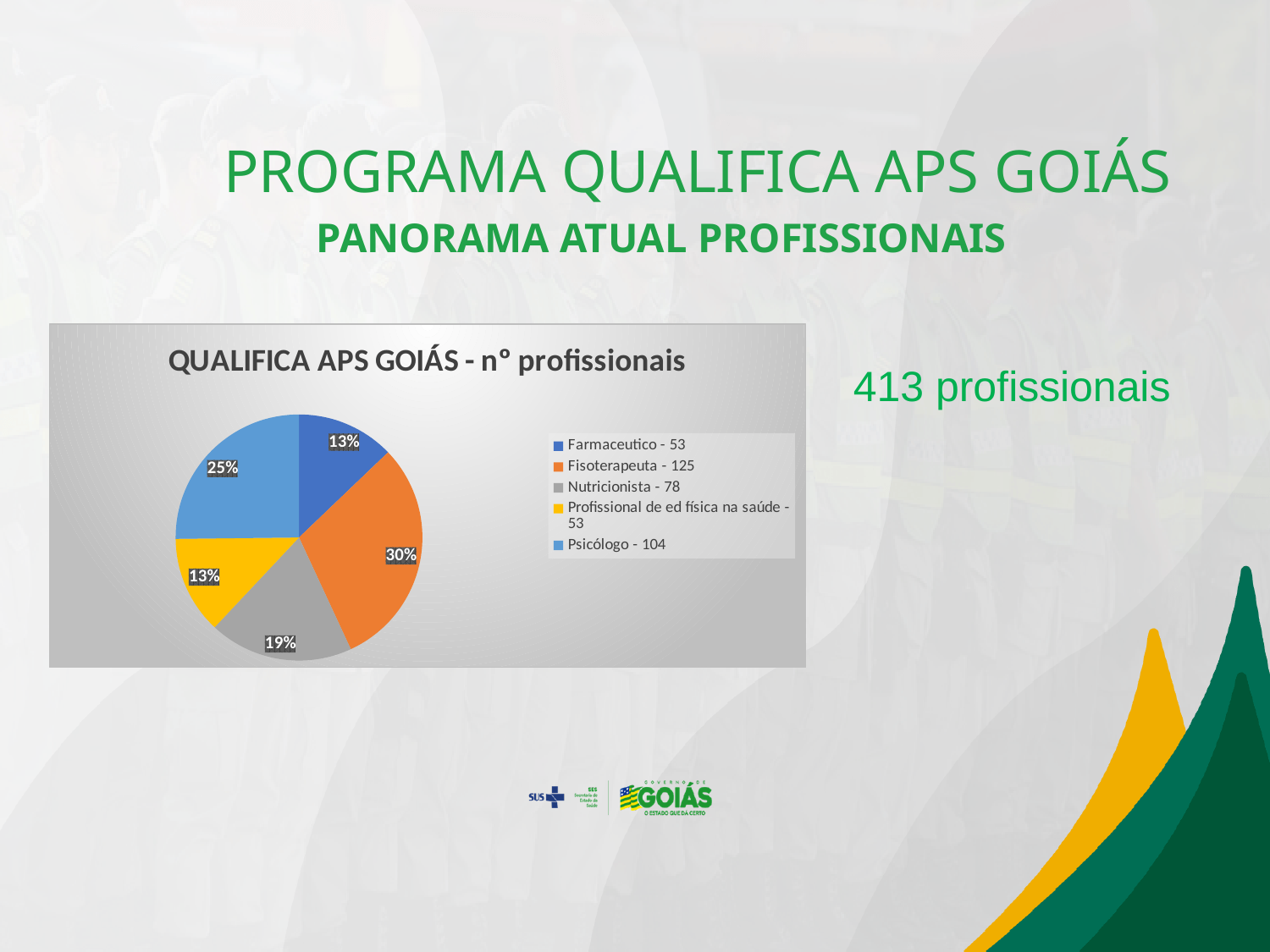
What share of the pie does Fisoterapeuta represent? 30% What is the difference between the number of Fisoterapeuta and Nutricionista professionals? 47 How many categories does the pie chart have? 5 What is the total number of professionals shown on the slide? 413 profissionais What type of chart is shown on the slide? pie chart Which has more professionals, Psicólogo or Farmaceutico? Psicólogo How many professionals are listed for Nutricionista in the legend? 78 Which category has the largest slice of the pie? Fisoterapeuta What share of the pie does Nutricionista represent? 19% What share of the pie does Psicólogo represent? 25% How many professionals are listed for Psicólogo in the legend? 104 What is the title of the chart? QUALIFICA APS GOIÁS - n° profissionais